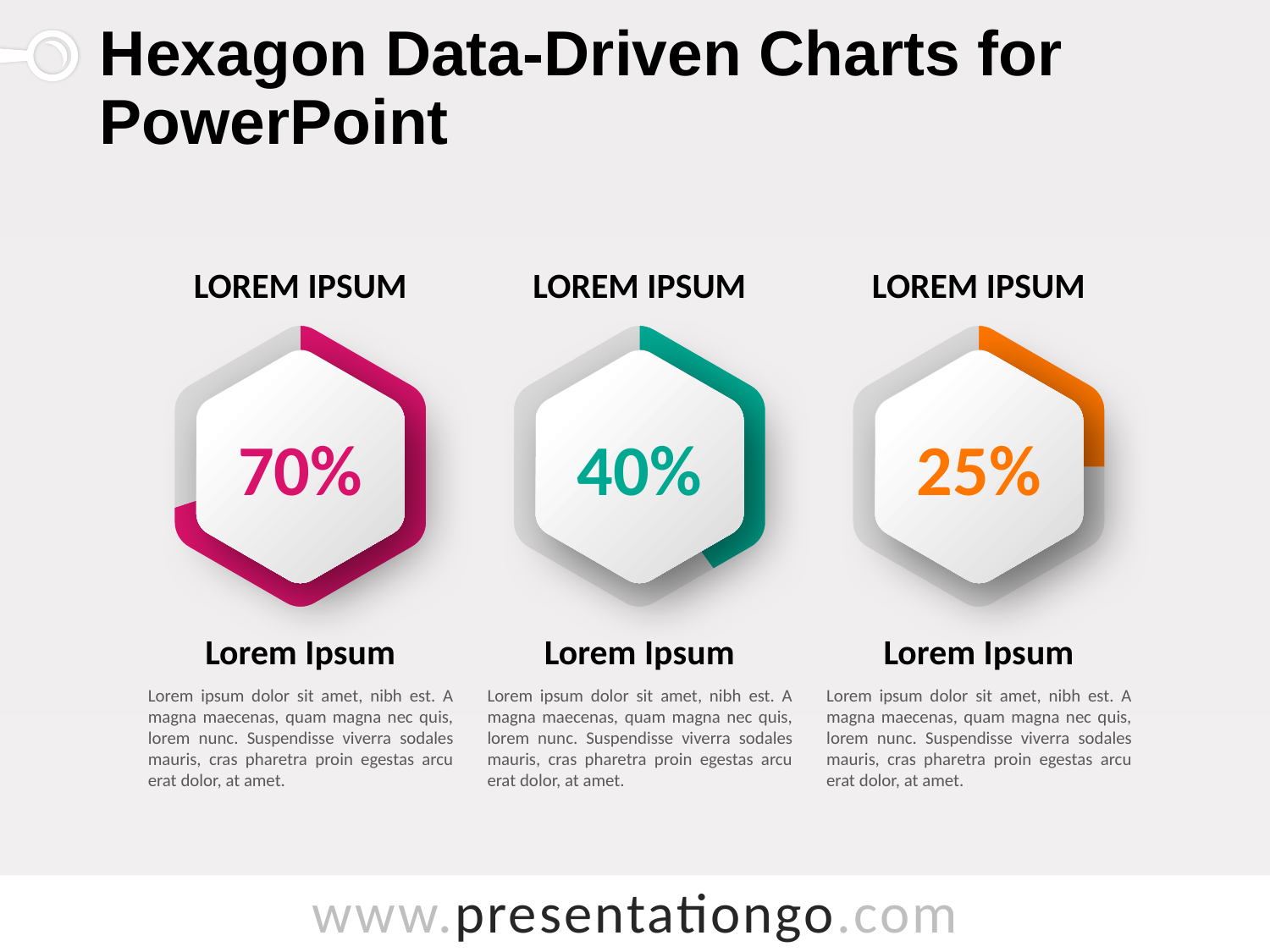
How many hexagon charts are shown on the slide? 3 What value is shown in the middle hexagon chart? 40% What colour is the filled portion of the right hexagon chart? Orange What is the difference between the value in the left hexagon chart and the value in the middle hexagon chart? 30% What is the difference between the value in the left hexagon chart and the value in the right hexagon chart? 45% Which of the three hexagon charts shows the lowest value? The right chart (25%) Is the value in the middle hexagon chart greater or less than 50%? less What value is shown in the left hexagon chart? 70% Which is larger, the value in the middle hexagon chart or the value in the right hexagon chart? The middle chart (40%) What value is shown in the right hexagon chart? 25% What colour is the filled portion of the middle hexagon chart? Teal (green) Which of the three hexagon charts shows the highest value? The left chart (70%)